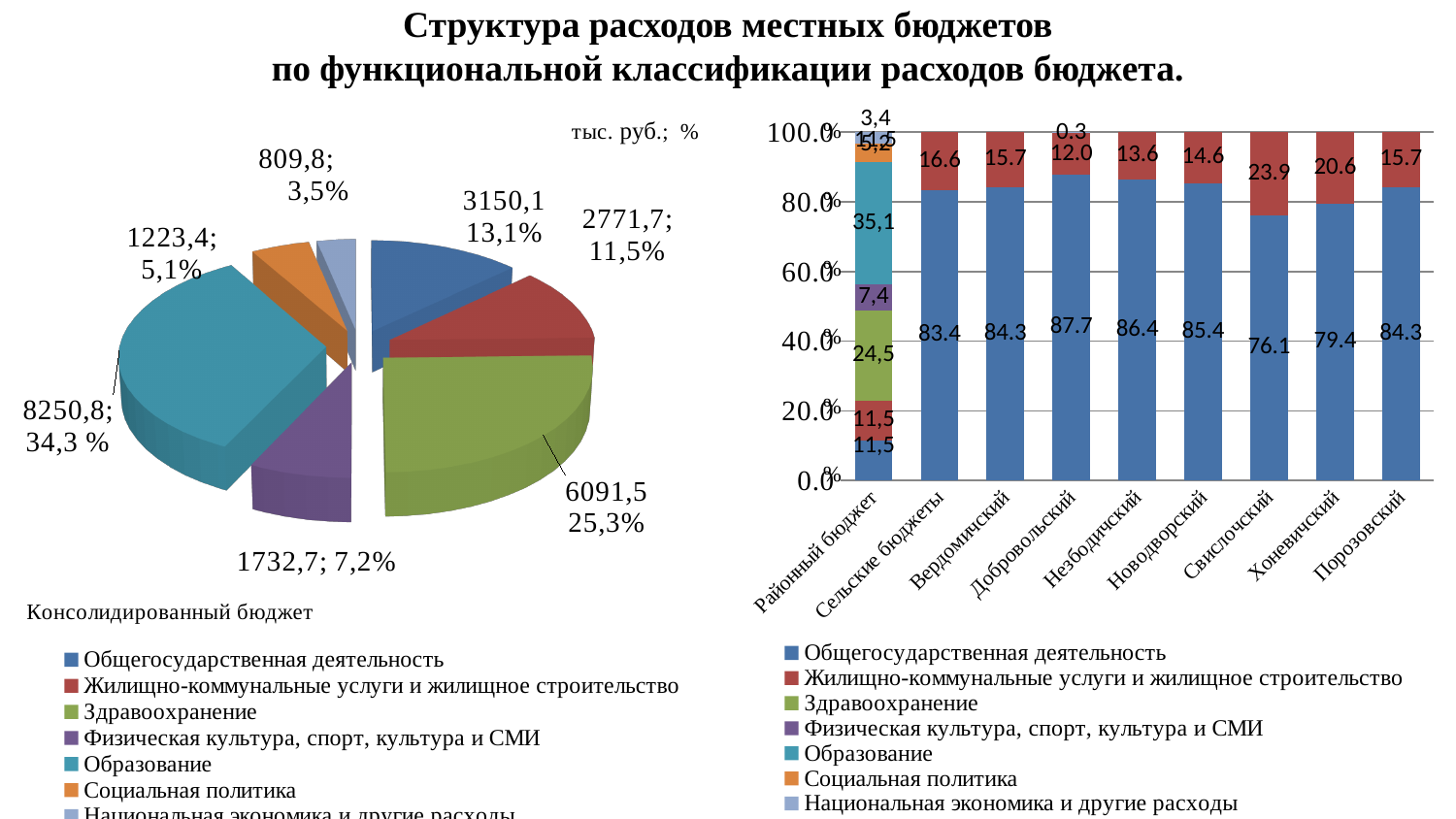
On the stacked bar chart (right), what is the value of Общегосударственная деятельность for Свислочский? 76.1 On the pie chart (left), which is larger: the slice for Общегосударственная деятельность or the slice for Жилищно-коммунальные услуги и жилищное строительство? Общегосударственная деятельность What type of chart is on the right side of the slide? Stacked bar chart On the pie chart (left), which category has the smallest slice? Национальная экономика и другие расходы On the stacked bar chart (right), what is the difference between the Жилищно-коммунальные услуги values for Свислочский and Вердомичский? 8.2 On the stacked bar chart (right), what is the value of Жилищно-коммунальные услуги и жилищное строительство for Добровольский? 12.0 On the pie chart (left), how many slices are there? 7 On the pie chart (left), what value and share are shown for Образование? 8250,8; 34,3 % On the stacked bar chart (right), which category has the highest value for Общегосударственная деятельность? Добровольский On the pie chart (left), which category has the largest slice? Образование On the pie chart (left), what percentage share is shown for Здравоохранение? 25,3% On the stacked bar chart (right), how many categories are shown on the x axis? 9